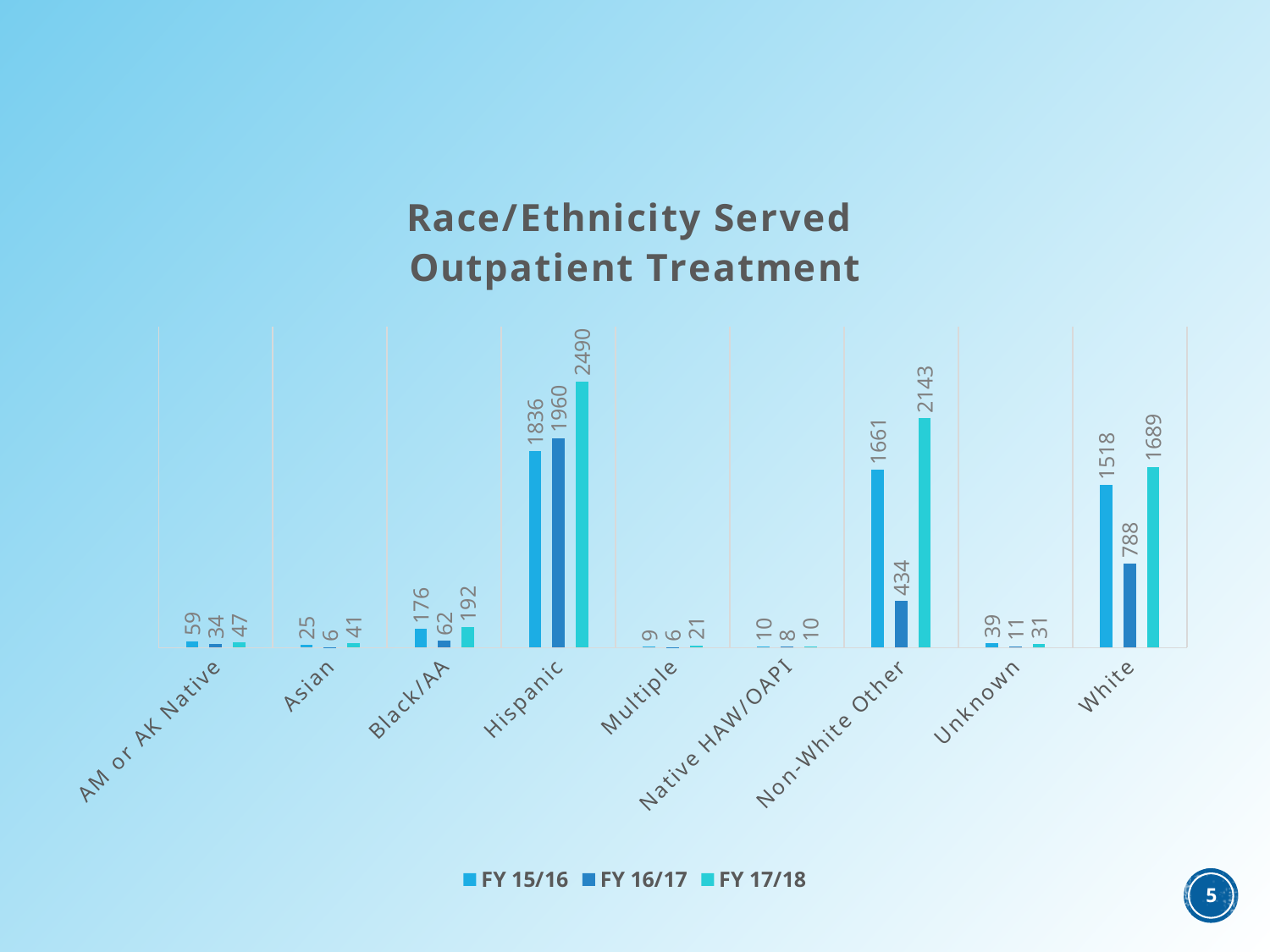
What is the FY 16/17 value for Non-White Other? 434 What kind of chart is shown on the slide? Bar chart Which category has the lowest FY 16/17 value? Asian and Multiple (tied at 6) Which category has the highest FY 17/18 value? Hispanic What is the FY 15/16 value for White? 1518 What is the FY 17/18 value for Hispanic? 2490 Which is larger for White: the FY 15/16 value or the FY 16/17 value? FY 15/16 What is the FY 17/18 value for Black/AA? 192 What is the difference between the FY 17/18 and FY 15/16 values for Non-White Other? 482 How many race/ethnicity categories are shown on the x axis? 9 How many series does the legend list? 3 What is the title of the chart? Race/Ethnicity Served Outpatient Treatment